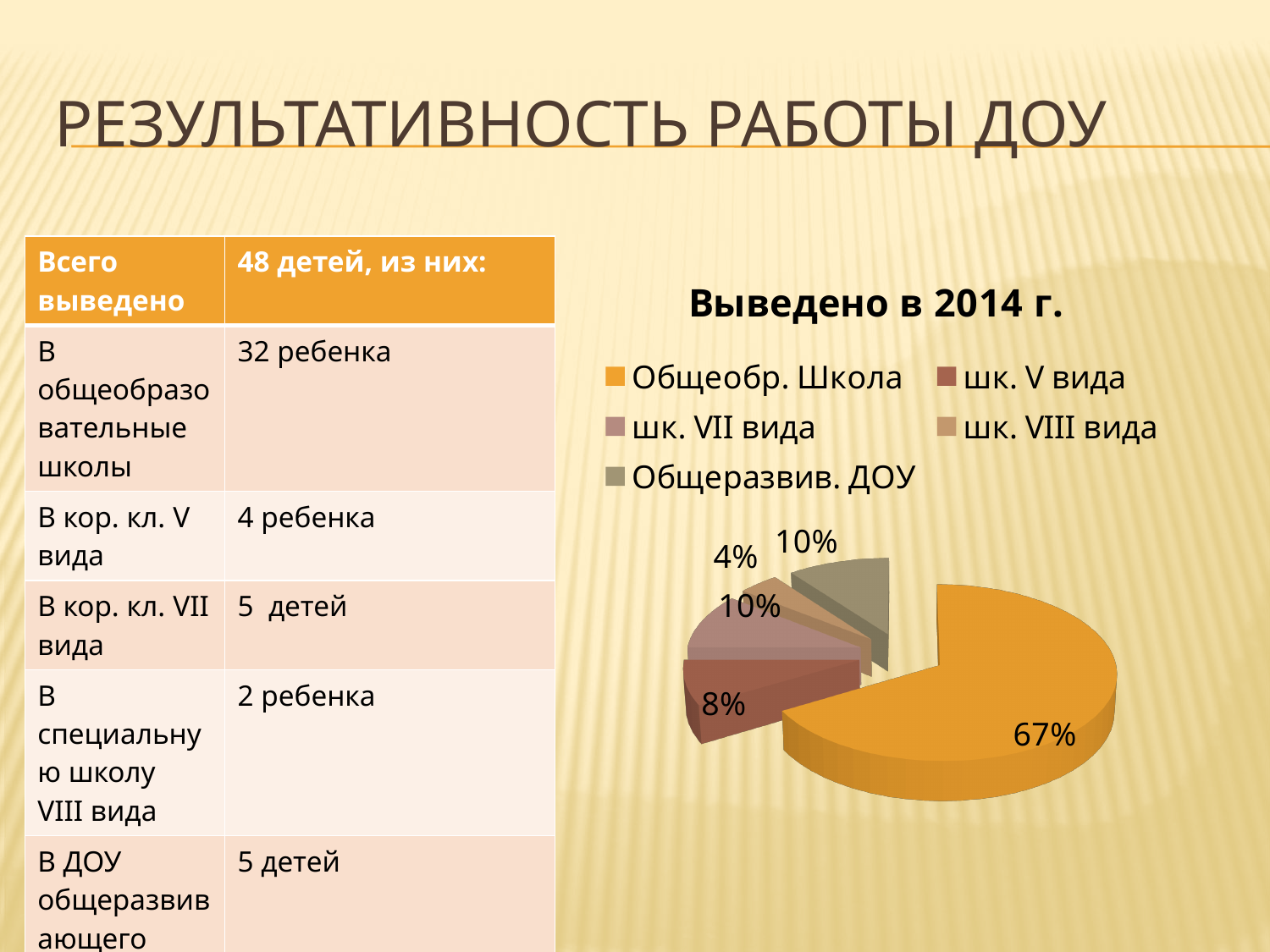
What is the difference in percentage points between the Общеобр. Школа slice and the шк. V вида slice? 59 How many slices does the pie chart have? 5 What share of the pie is labelled for шк. VIII вида? 4% What kind of chart is shown on the slide? pie chart Which slice is larger, шк. V вида or шк. VII вида? шк. VII вида What share of the pie is labelled for шк. V вида? 8% Which category has the largest slice of the pie? Общеобр. Школа How many entries does the chart legend list? 5 What is the title of the chart? Выведено в 2014 г. What share of the pie is labelled for Общеобр. Школа? 67% Which category has the smallest slice of the pie? шк. VIII вида What share of the pie is labelled for Общеразвив. ДОУ? 10%